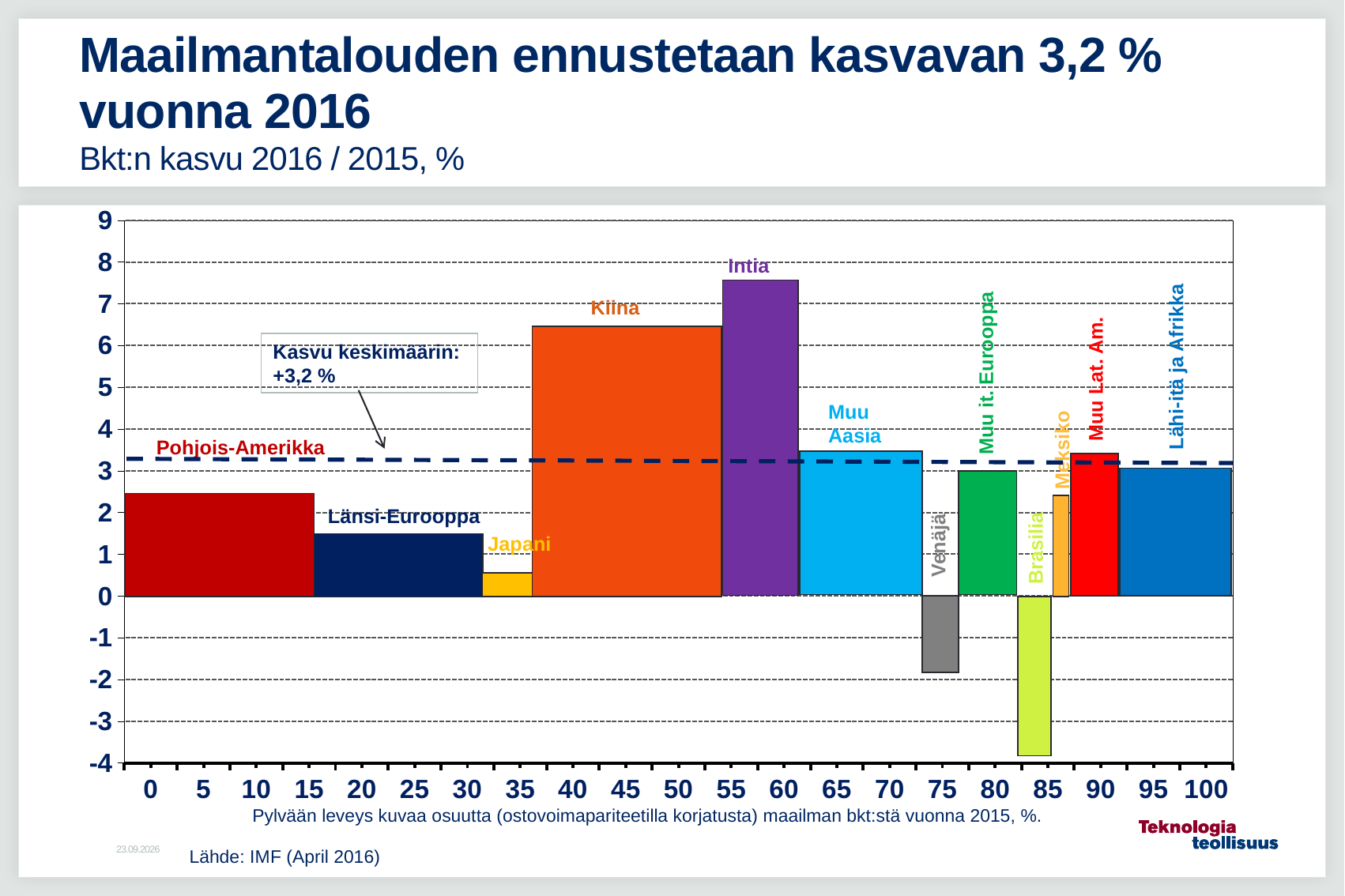
Is the value for Kiina greater or less than 6? greater Which has the lower growth, Venäjä or Brasilia? Brasilia Which has the higher growth, Kiina or Intia? Intia Is the value for Venäjä greater or less than -1? less Is the value for Japani greater or less than 1? less What average growth value is given in the annotation box on the chart? +3,2 % Which region has the lowest GDP growth in the chart? Brasilia What kind of chart is shown on the slide? bar chart How many regions are plotted as bars in the chart? 12 Which region has the highest GDP growth in the chart? Intia What is the subtitle describing the measure shown in the chart? Bkt:n kasvu 2016 / 2015, %